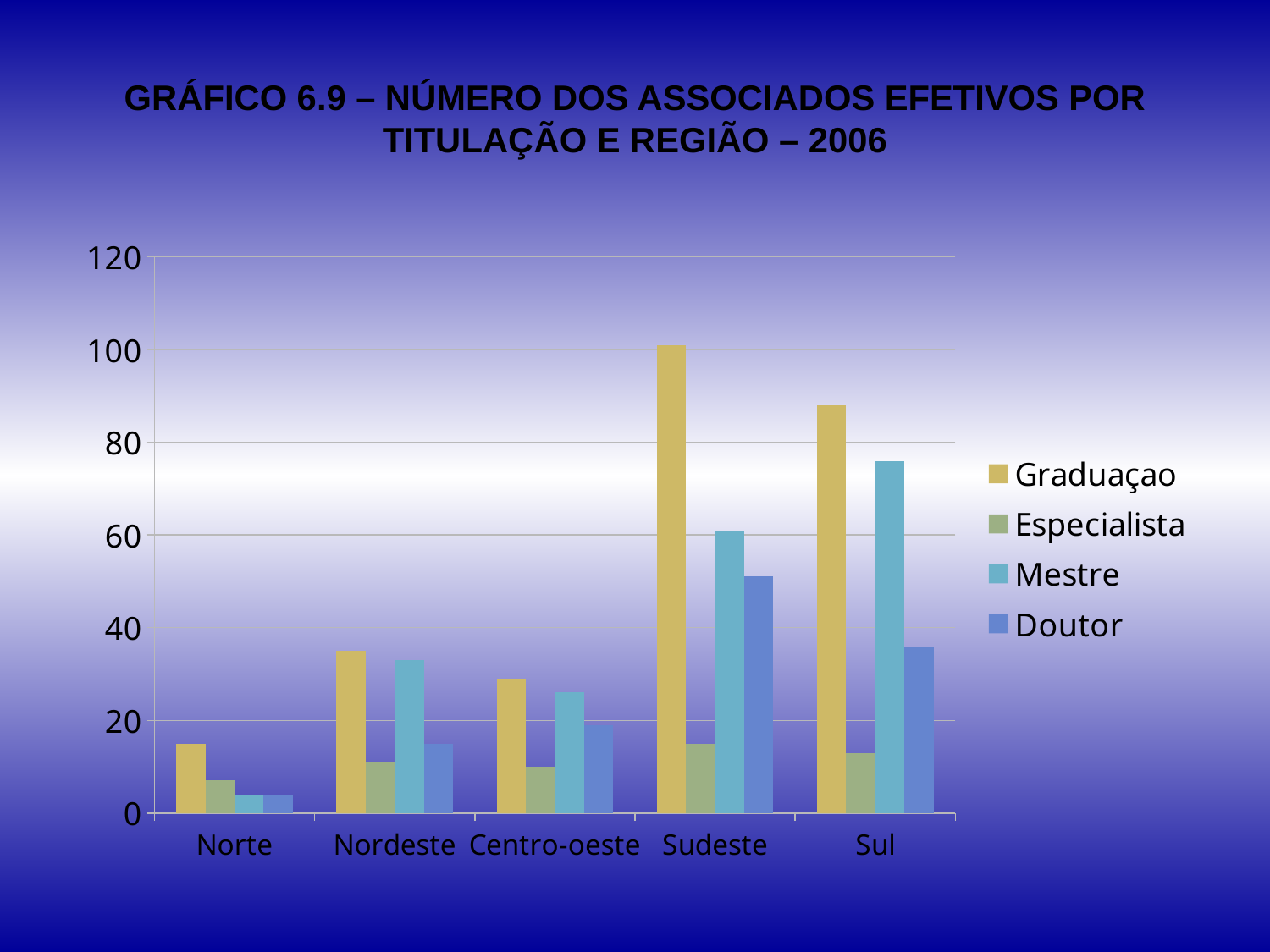
Which region has the lowest Doutor value? Norte How many series does the legend list? 4 Which region has the highest Graduaçao value? Sudeste Which region has the lowest Graduaçao value? Norte Which is larger, the Doutor value for Sudeste or the Doutor value for Sul? Sudeste How many regions are shown on the x axis? 5 Which region has the highest Mestre value? Sul Is the Graduaçao value for Nordeste greater or less than 40? less What colour represents the Graduaçao series in the legend? yellow What kind of chart is shown on the slide? bar chart Is the Mestre value for Sul greater or less than 60? greater Is the Graduaçao value for Sudeste greater or less than 80? greater